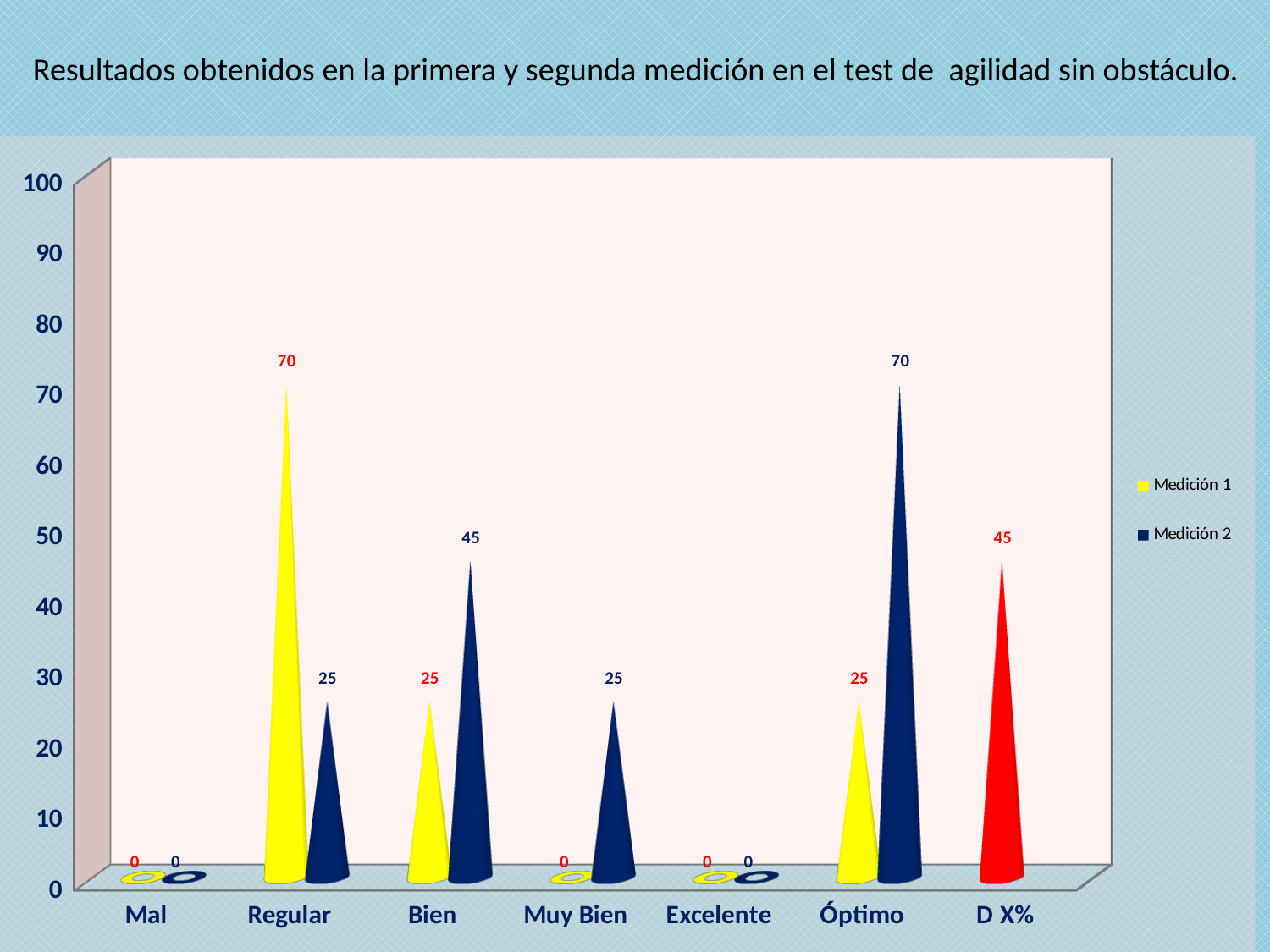
What is the value of Medición 2 for Bien? 45 What is the difference between Medición 1 and Medición 2 for Regular? 45 Which category has the highest value for Medición 2? Óptimo How many series does the legend list? 2 Which category has the highest value for Medición 1? Regular What kind of chart is shown on the slide? Bar chart What is the value of Medición 1 for Regular? 70 Which is larger for Bien, Medición 1 or Medición 2? Medición 2 What colour represents Medición 2 in the legend? Dark blue How many categories are shown on the x axis? 7 What is the value of Medición 2 for Muy Bien? 25 What is the value of Medición 2 for Óptimo? 70